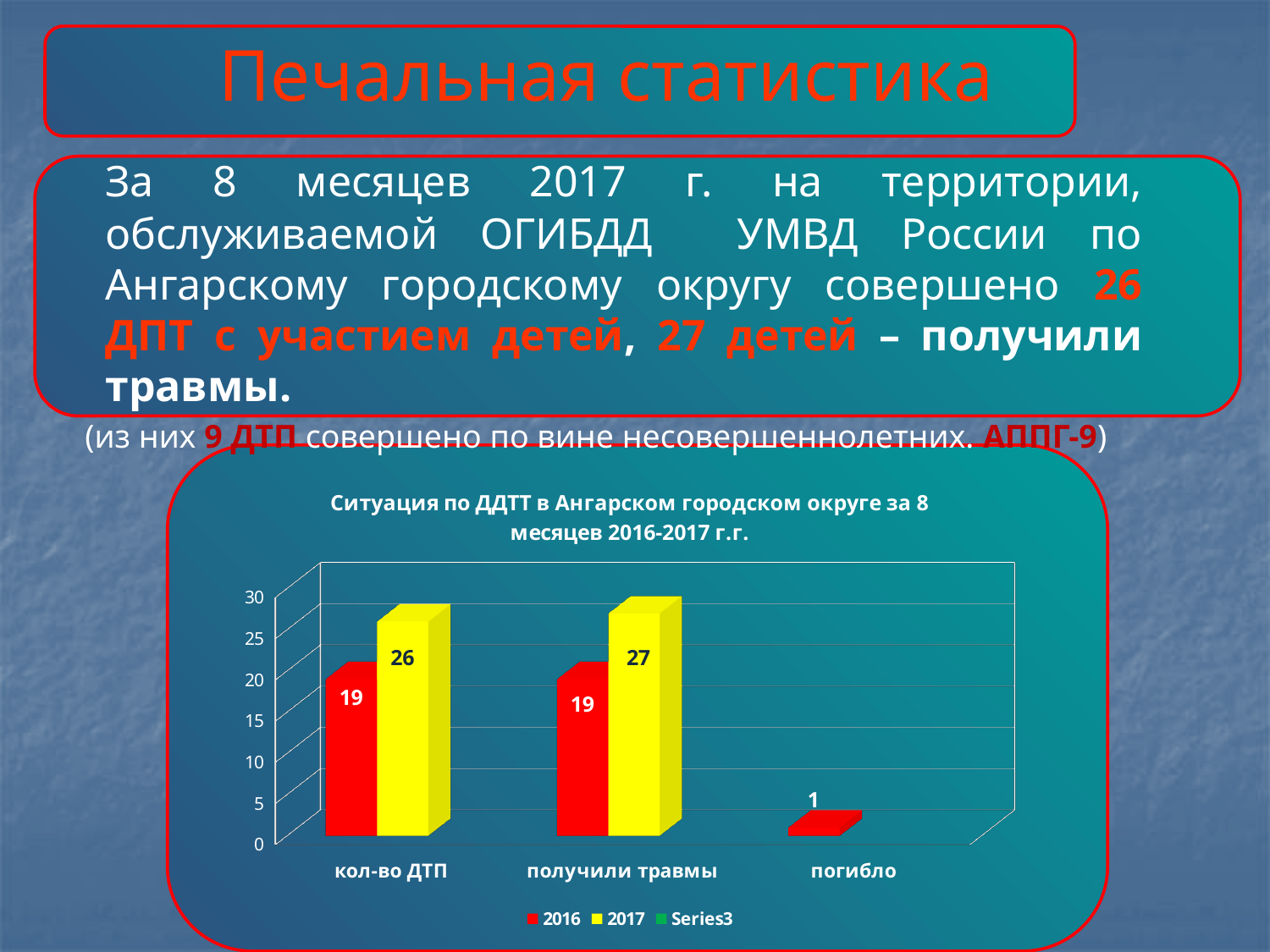
How many series does the legend list? 3 What colour are the bars for the 2017 series? yellow Which category has the lowest value for the 2016 series? погибло What is the value for 2017 in the "получили травмы" category? 27 Which is larger in the "получили травмы" category: the 2016 value or the 2017 value? 2017 Which category has the highest value for the 2017 series? получили травмы What is the value for 2016 in the "получили травмы" category? 19 What is the value for 2016 in the "погибло" category? 1 What is the difference between the 2017 and 2016 values in the "кол-во ДТП" category? 7 How many categories are shown on the x axis? 3 What kind of chart is shown on the slide? bar chart What is the value for 2017 in the "кол-во ДТП" category? 26